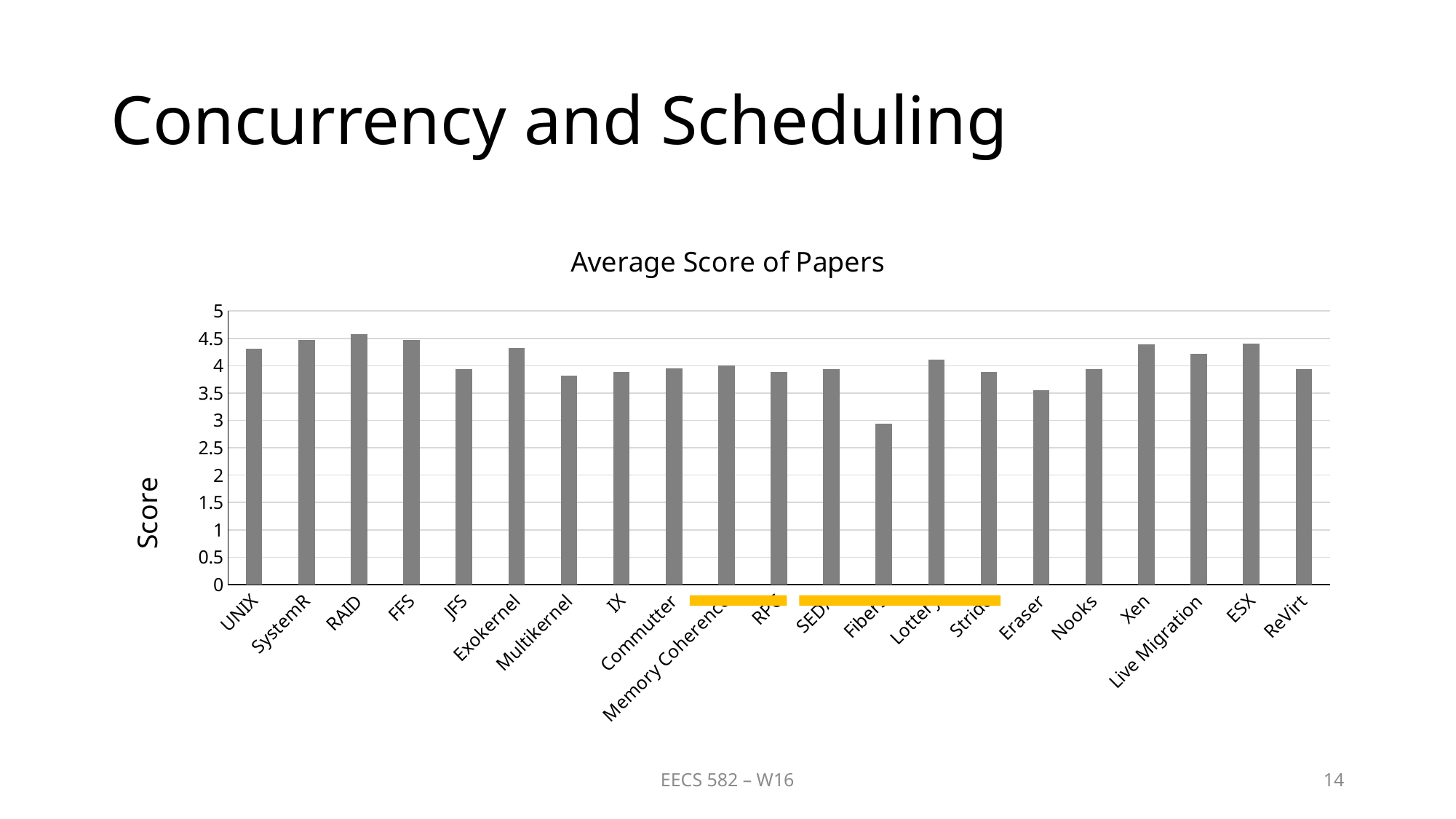
Is the value for Multikernel greater or less than 4? less What is the label on the vertical axis of the chart? Score Is the value for Xen greater or less than 4? greater Which has the larger average score, ESX or ReVirt? ESX Which has the larger average score, RAID or Eraser? RAID How many papers (categories) are plotted in the chart? 21 What is the title of the chart? Average Score of Papers Which paper has the highest average score? RAID Which has the larger average score, Multikernel or Eraser? Multikernel What kind of chart is shown on the slide? bar chart Is the value for UNIX greater or less than 4? greater